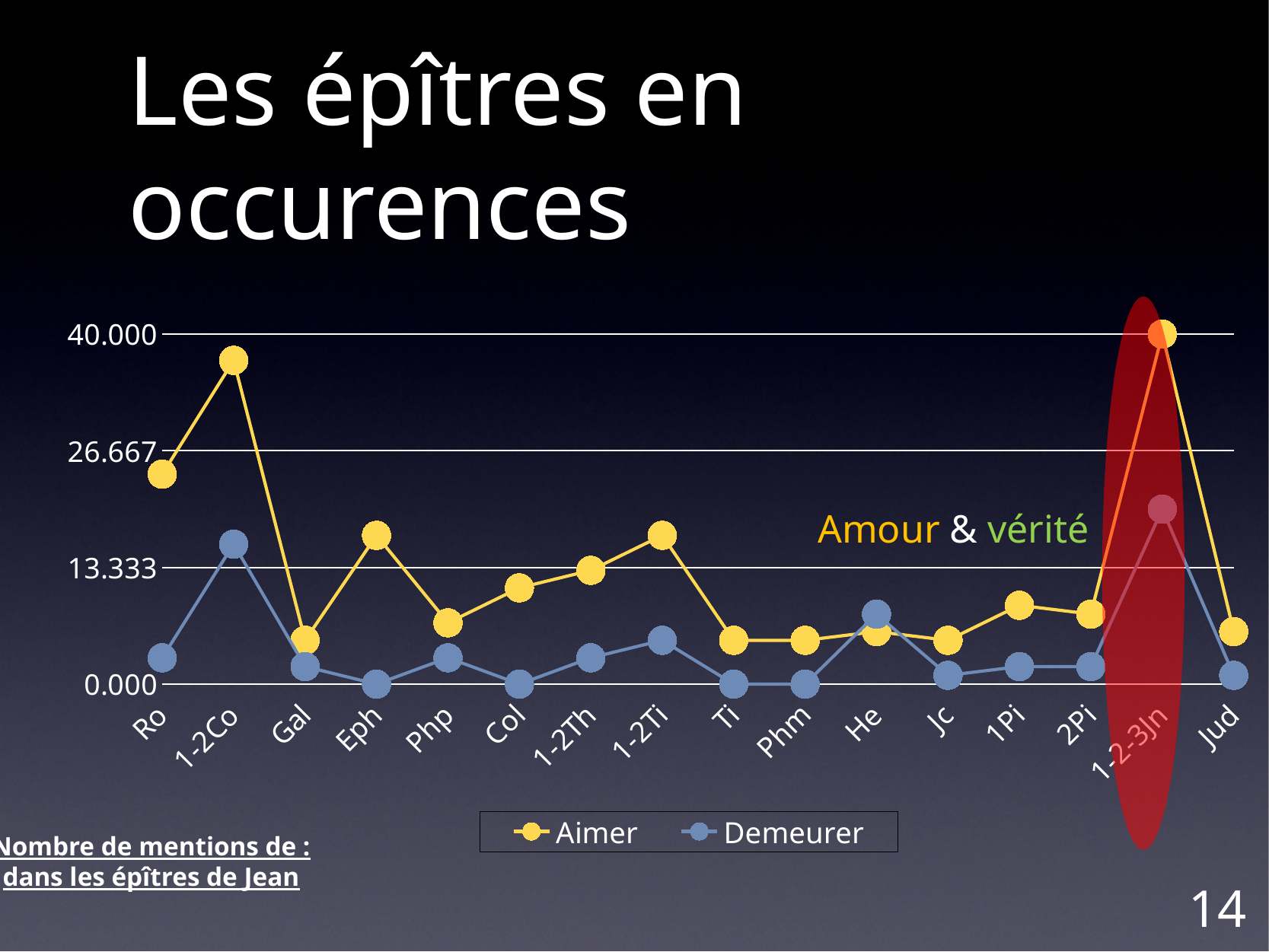
At Ro, which series has the larger value, Aimer or Demeurer? Aimer How many categories are shown along the x axis? 16 Is the value for Aimer at Gal greater or less than 13.333? less At He, which series has the larger value, Aimer or Demeurer? Demeurer Which category has the highest value for the Demeurer series? 1-2-3Jn Which category has the highest value for the Aimer series? 1-2-3Jn How many series does the legend list? 2 What kind of chart is shown on the slide? line chart Is the value for Demeurer at 1-2-3Jn greater or less than 13.333? greater Which two series are listed in the legend? Aimer and Demeurer Is the value for Aimer at 1-2Co greater or less than 26.667? greater